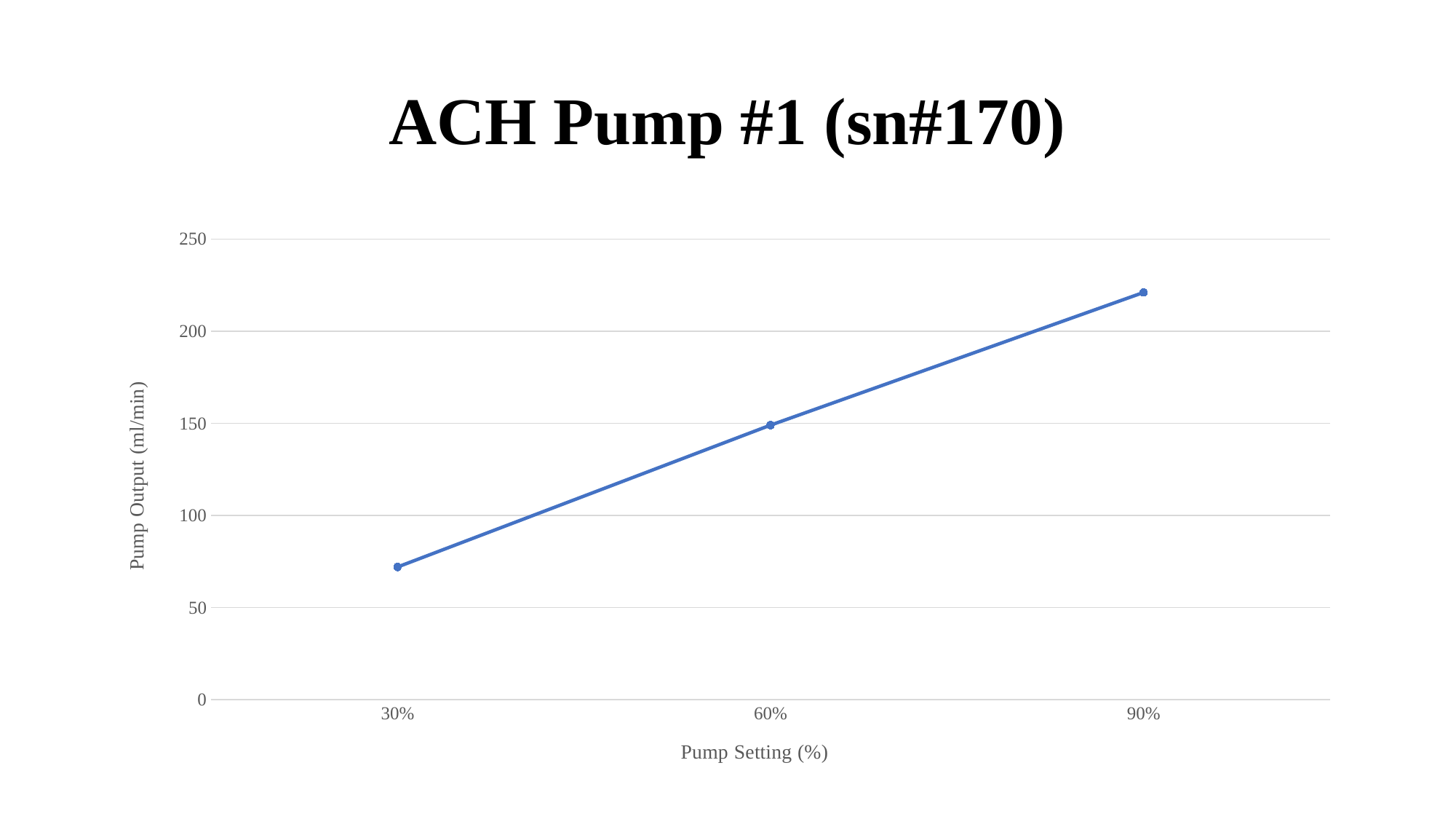
What kind of chart is shown on the slide? line chart Which has the larger pump output, the 60% setting or the 90% setting? 90% What is the label of the y axis? Pump Output (ml/min) Does the pump output rise or fall as the pump setting increases from 30% to 90%? rise Which pump setting has the lowest pump output? 30% Is the pump output at the 90% setting greater or less than 200? greater How many data points are plotted on the line? 3 Which pump setting has the highest pump output? 90% Is the pump output at the 30% setting greater or less than 50? greater Is the pump output at the 60% setting greater or less than 100? greater What is the title of the chart? ACH Pump #1 (sn#170)